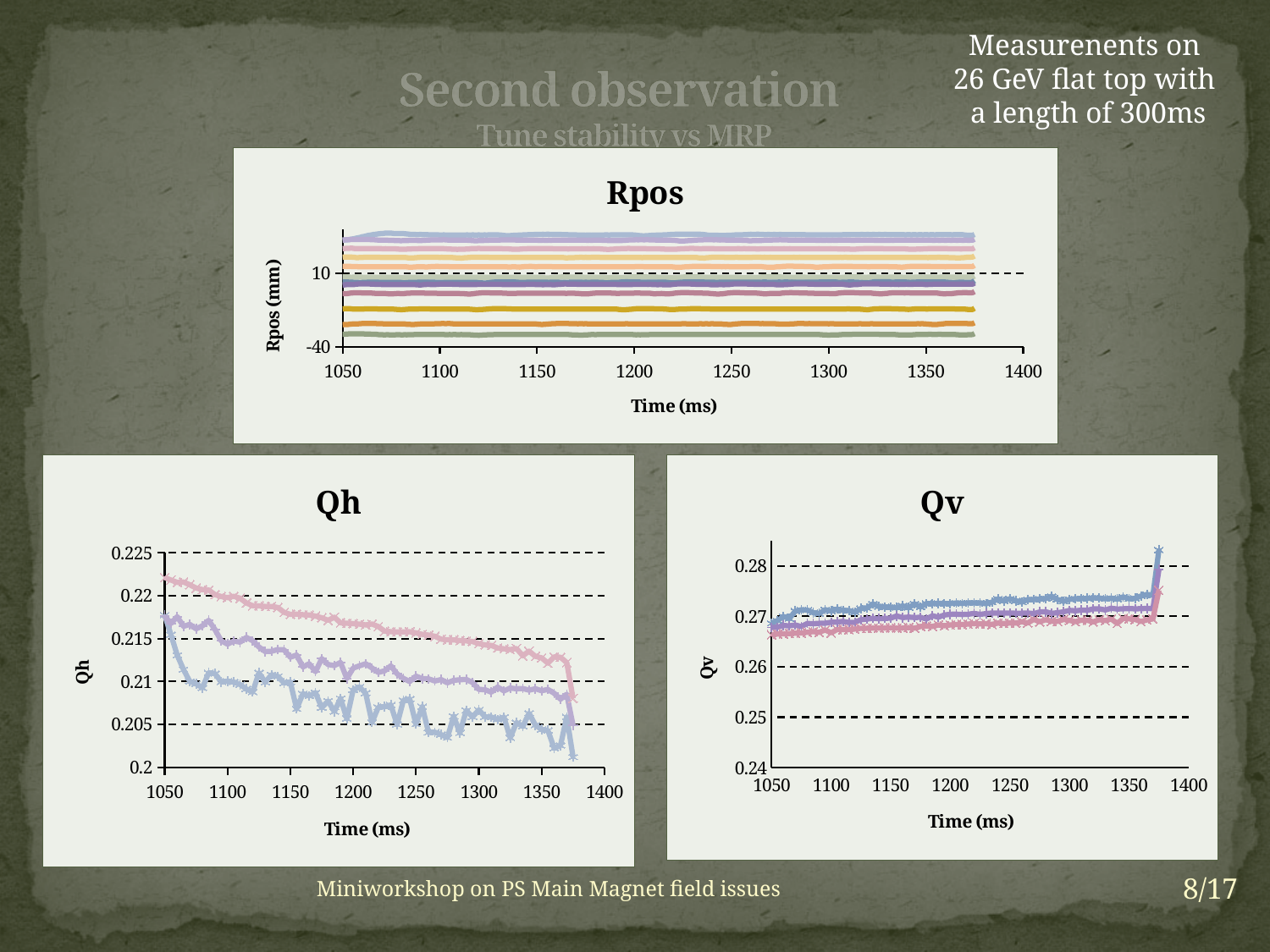
What is the title of the chart at the bottom right of the slide? Qv In the Qh chart, is the value of the topmost (pink) series at 1050 ms greater or less than 0.22? greater How many charts are shown on the slide? 3 What kind of chart is the Rpos chart at the top of the slide? line chart In the Qh chart, do the values generally rise or fall as time increases from 1050 to 1350 ms? fall What kind of chart is the Qh chart at the bottom left? line chart In the Qh chart, which series is highest at 1100 ms, the pink series or the blue series? pink series In the Qv chart, do the values generally rise or fall as time increases from 1050 to 1350 ms? rise What is the label of the x axis on the Rpos chart? Time (ms) In the Qh chart, is the value of the lowest (blue) series at 1300 ms greater or less than 0.21? less In the Qv chart, are the plotted values at 1200 ms greater or less than 0.26? greater